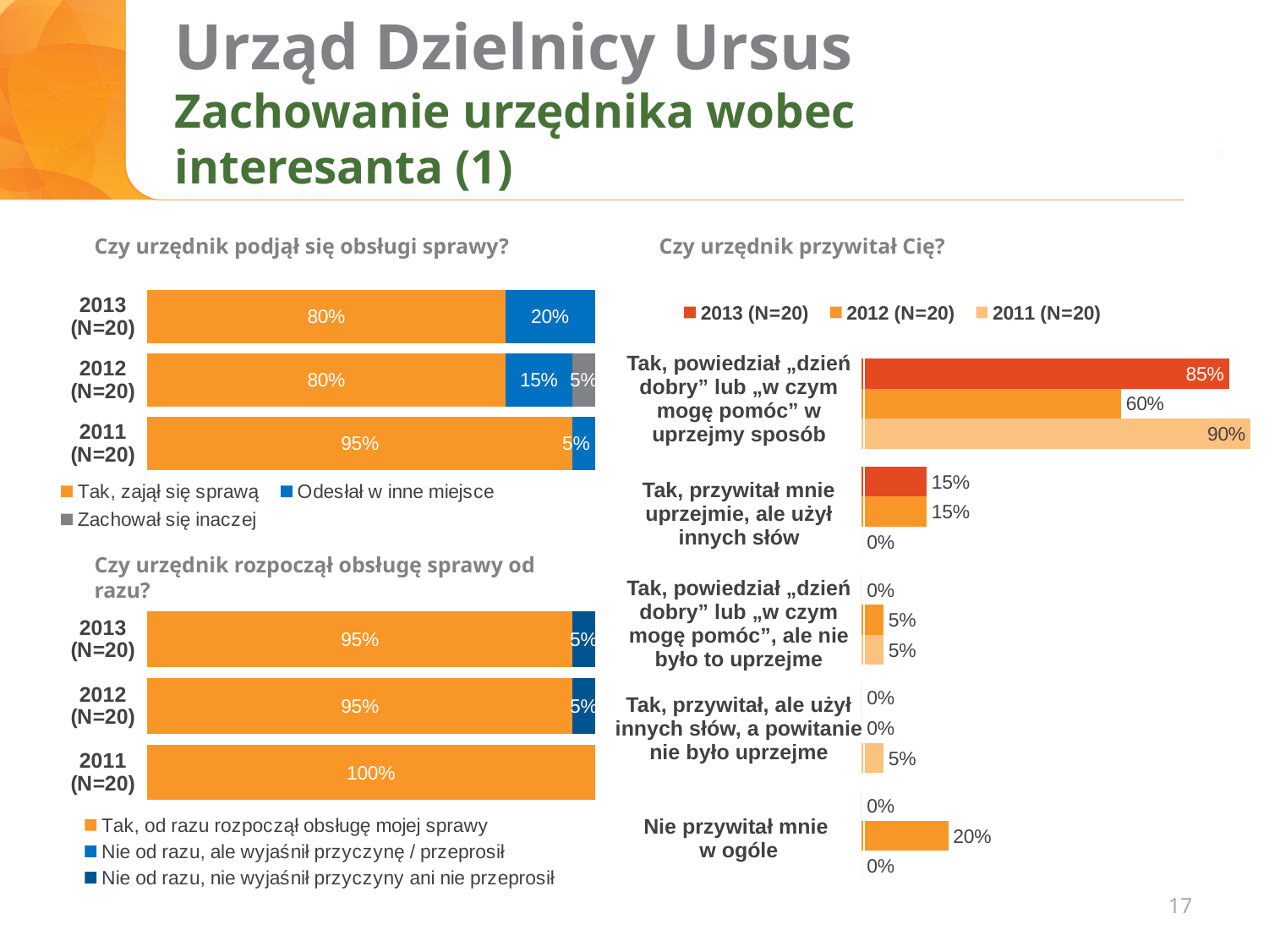
In the chart "Czy urzędnik podjął się obsługi sprawy?", which year has the highest value for "Tak, zajął się sprawą"? 2011 (N=20) In the chart "Czy urzędnik rozpoczął obsługę sprawy od razu?", what is the value for "Tak, od razu rozpoczął obsługę mojej sprawy" in 2011 (N=20)? 100% In the chart "Czy urzędnik rozpoczął obsługę sprawy od razu?", what is the difference between the 2011 and 2013 values for "Tak, od razu rozpoczął obsługę mojej sprawy"? 5% How many categories are shown in the chart "Czy urzędnik przywitał Cię?"? 5 In the chart "Czy urzędnik podjął się obsługi sprawy?", what is the value for "Tak, zajął się sprawą" in 2013 (N=20)? 80% In the chart "Czy urzędnik przywitał Cię?", which year has the highest value for "Tak, powiedział „dzień dobry” lub „w czym mogę pomóc” w uprzejmy sposób"? 2011 (N=20) In the chart "Czy urzędnik podjął się obsługi sprawy?", how many series does the legend list? 3 In the chart "Czy urzędnik podjął się obsługi sprawy?", what is the value for "Odesłał w inne miejsce" in 2012 (N=20)? 15% In the chart "Czy urzędnik przywitał Cię?", what is the difference between the 2013 and 2012 values for "Tak, powiedział „dzień dobry” lub „w czym mogę pomóc” w uprzejmy sposób"? 25% In the chart "Czy urzędnik przywitał Cię?", what is the 2012 (N=20) value for "Nie przywitał mnie w ogóle"? 20% What kind of chart is "Czy urzędnik rozpoczął obsługę sprawy od razu?"? Stacked bar chart In the chart "Czy urzędnik przywitał Cię?", what is the 2012 (N=20) value for "Tak, powiedział „dzień dobry” lub „w czym mogę pomóc” w uprzejmy sposób"? 60%